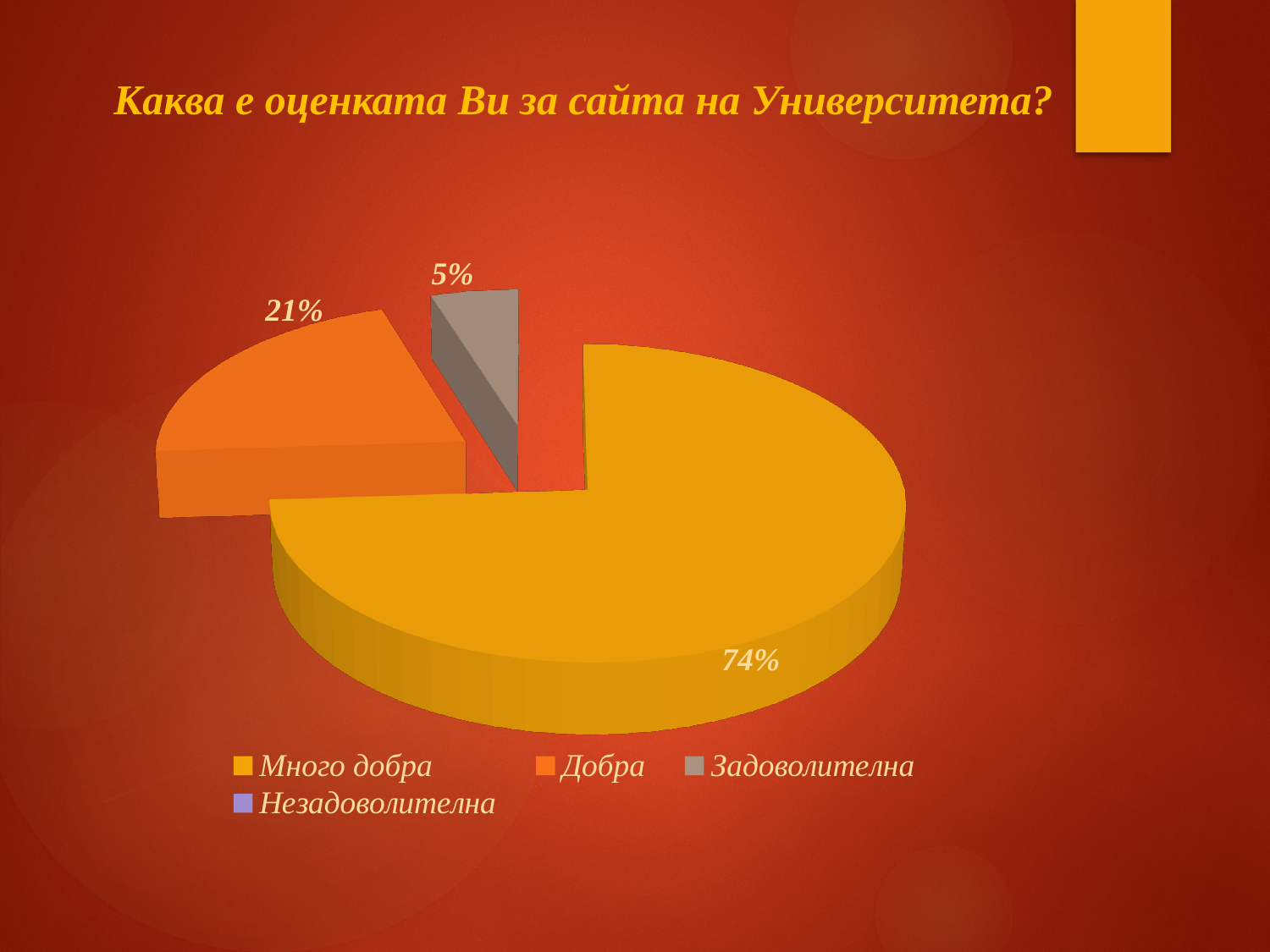
What is the title of the chart? Каква е оценката Ви за сайта на Университета? Which category has the largest slice of the pie? Много добра What is the value shown for "Задоволителна"? 5% What kind of chart is shown on the slide? pie chart What is the difference in percentage points between "Много добра" and "Добра"? 53 What share of the pie does "Много добра" take? 74% Which is larger, the share for "Добра" or the share for "Задоволителна"? Добра What is the value shown for "Добра"? 21% How many categories does the legend list? 4 Which of the visible slices is the smallest? Задоволителна How many slices with data labels are visible in the pie? 3 What colour is the slice for "Задоволителна"? grey